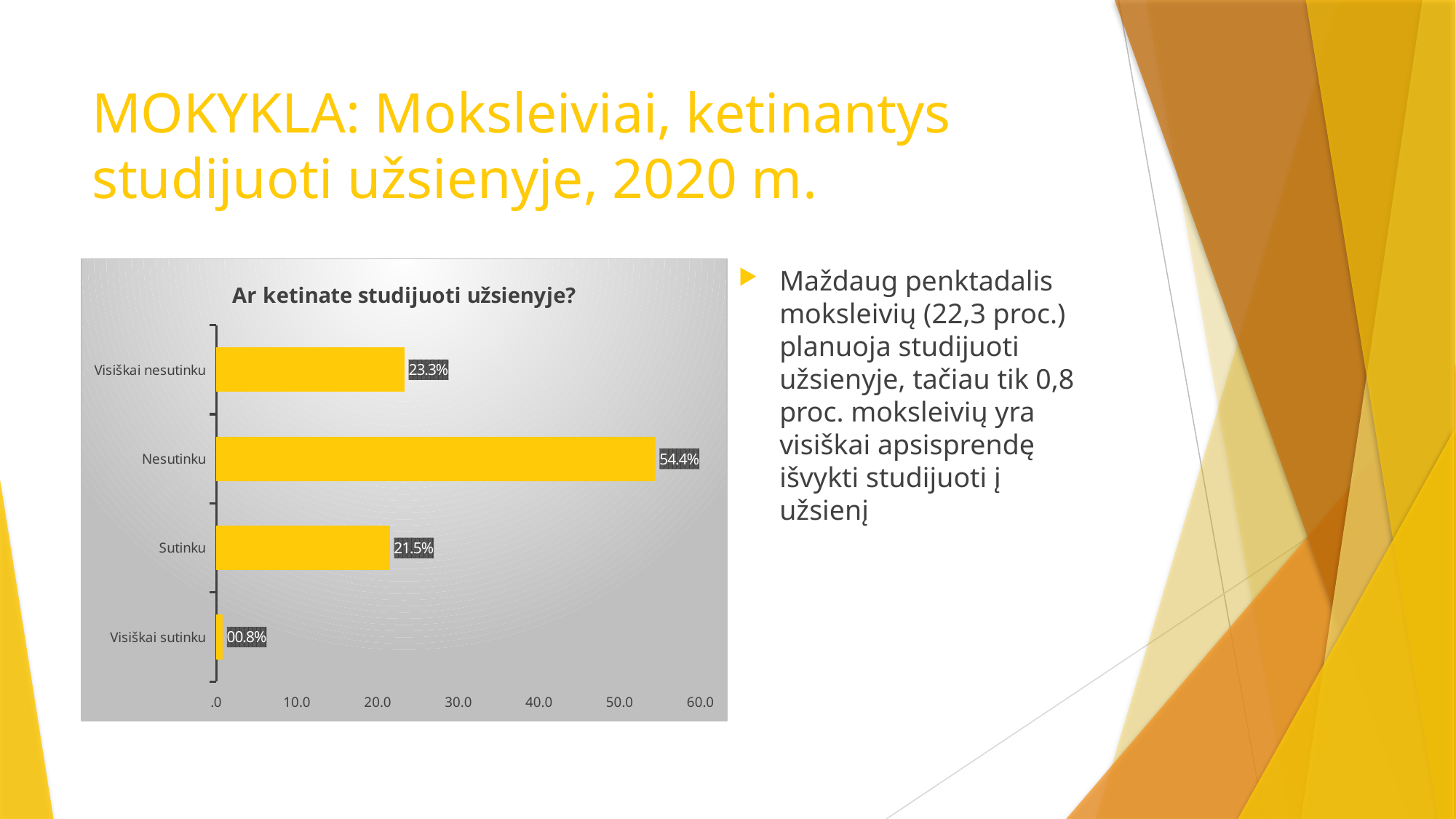
Which is larger, the value for Nesutinku or the value for Sutinku? Nesutinku What is the value for Visiškai nesutinku? 23.3% What is the value for Visiškai sutinku? 00.8% What is the value for Nesutinku? 54.4% Which category has the lowest value? Visiškai sutinku Which category has the highest value? Nesutinku Is the value for Nesutinku greater or less than 50.0? greater What type of chart is shown on the slide? Bar chart How many categories are shown in the chart? 4 What is the value for Sutinku? 21.5% What is the difference between the values for Nesutinku and Visiškai nesutinku? 31.1% What is the difference between the values for Visiškai nesutinku and Sutinku? 1.8%